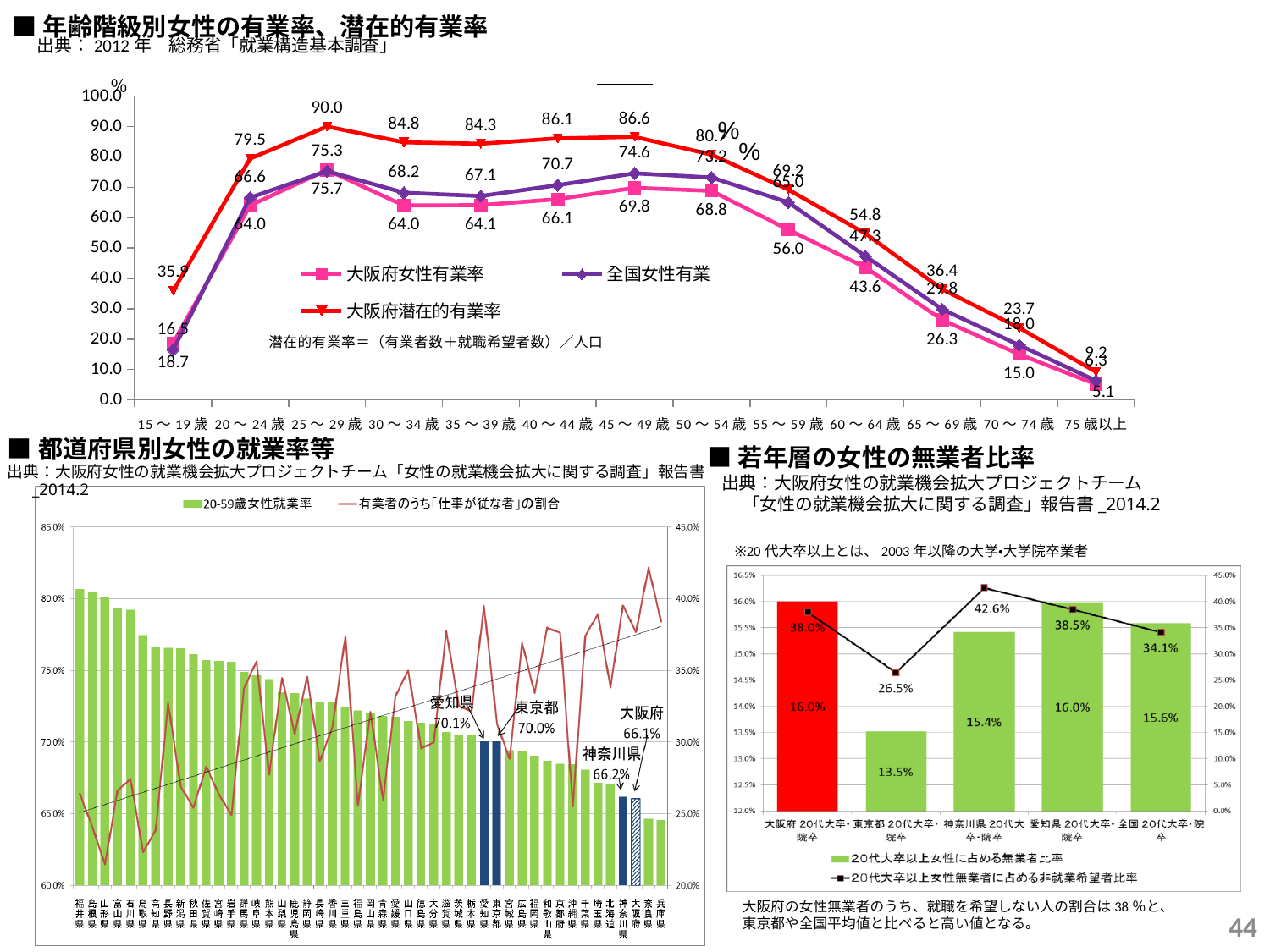
In the top chart (年齢階級別女性の有業率、潜在的有業率), how many series does the legend list? 3 In the bottom-right chart (若年層の女性の無業者比率), which prefecture has the highest 20代大卒以上女性無業者に占める非就業希望者比率? 神奈川県 In the top chart (年齢階級別女性の有業率、潜在的有業率), do the values of 大阪府潜在的有業率 rise or fall from 45～49歳 to 75歳以上? fall In the top chart (年齢階級別女性の有業率、潜在的有業率), what is the value of 全国女性有業 for 45～49歳? 74.6 In the bottom-right chart (若年層の女性の無業者比率), how many categories are shown on the x axis? 5 In the bottom-left chart (都道府県別女性の就業率等), what is the 20-59歳女性就業率 for 大阪府? 66.1% In the bottom-left chart (都道府県別女性の就業率等), which has the higher 20-59歳女性就業率, 愛知県 or 神奈川県? 愛知県 In the top chart (年齢階級別女性の有業率、潜在的有業率), what is the value of 大阪府潜在的有業率 for 25～29歳? 90.0 What kind of chart is the top chart (年齢階級別女性の有業率、潜在的有業率)? line chart In the bottom-right chart (若年層の女性の無業者比率), what is the 20代大卒以上女性に占める無業者比率 for 東京都? 13.5% In the top chart (年齢階級別女性の有業率、潜在的有業率), what is the difference between 大阪府潜在的有業率 and 大阪府女性有業率 for 55～59歳? 13.2 In the top chart (年齢階級別女性の有業率、潜在的有業率), which age group has the highest 大阪府潜在的有業率? 25～29歳